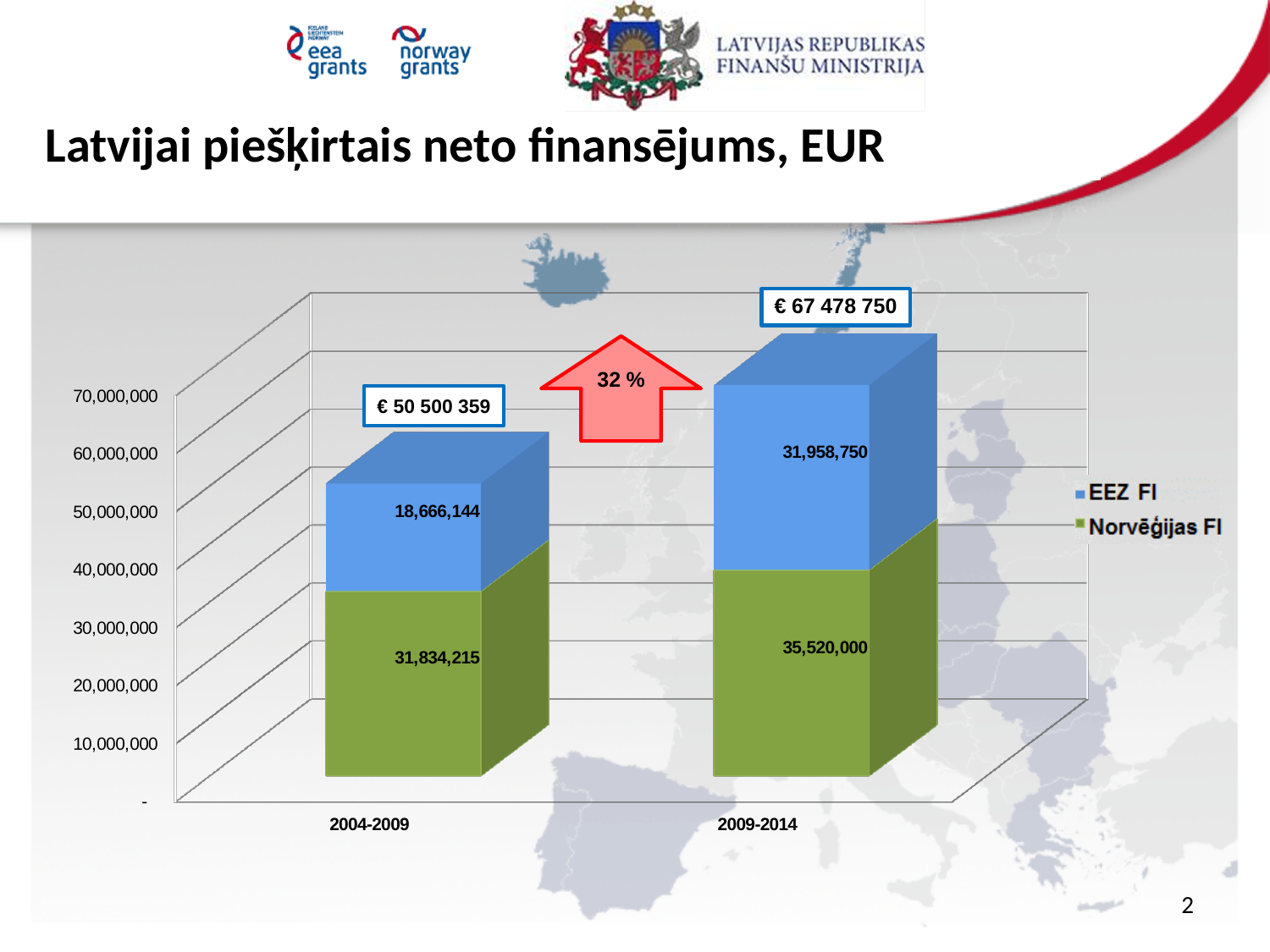
Which period has the higher total funding, 2004-2009 or 2009-2014? 2009-2014 How many series does the legend list? 2 Which series has the larger value in 2004-2009, EEZ FI or Norvēģijas FI? Norvēģijas FI What percentage increase is shown on the arrow between the two bars? 32 % What is the value for Norvēģijas FI in 2009-2014? 35,520,000 What is the total of the stacked bar for 2009-2014, as labelled on the slide? € 67 478 750 What is the difference between the EEZ FI values for 2009-2014 and 2004-2009? 13,292,606 What is the value for Norvēģijas FI in 2004-2009? 31,834,215 What is the total of the stacked bar for 2004-2009, as labelled on the slide? € 50 500 359 What is the value for EEZ FI in 2009-2014? 31,958,750 What kind of chart is shown on the slide? Stacked bar chart What is the value for EEZ FI in 2004-2009? 18,666,144